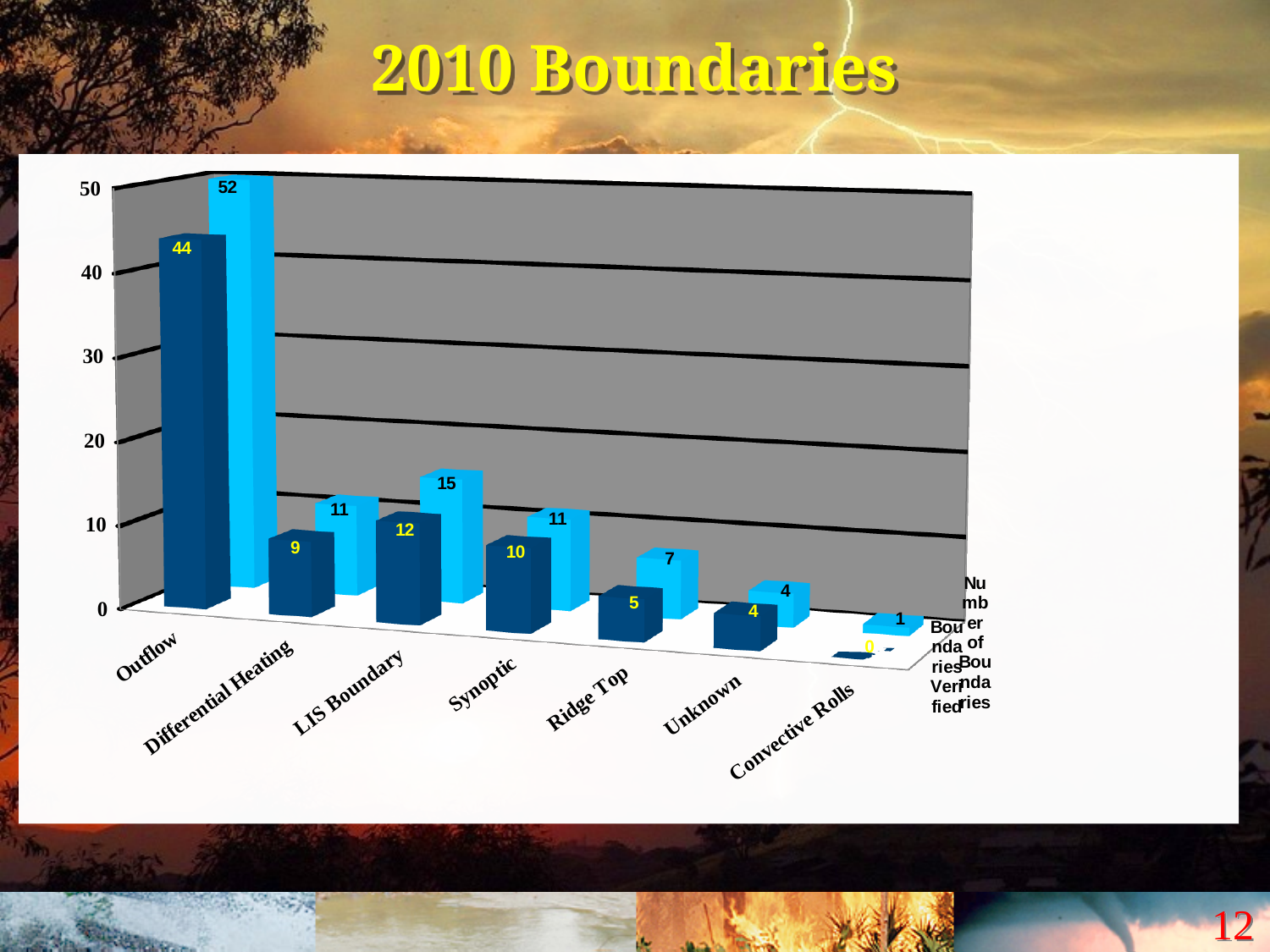
Which category has the lowest Boundaries Verified value? Convective Rolls What is the Number of Boundaries value for Ridge Top? 7 How many series does the chart show? 2 How many categories are shown on the x axis? 7 What is the title of the slide? 2010 Boundaries Which is larger: the Number of Boundaries for LIS Boundary or for Synoptic? LIS Boundary Which category has the highest Number of Boundaries? Outflow Is the Boundaries Verified value for Outflow greater or less than 40? greater What is the Boundaries Verified value for LIS Boundary? 12 What kind of chart is shown on the slide? bar chart What is the Number of Boundaries value for Outflow? 52 What is the difference between the Number of Boundaries and Boundaries Verified for Outflow? 8